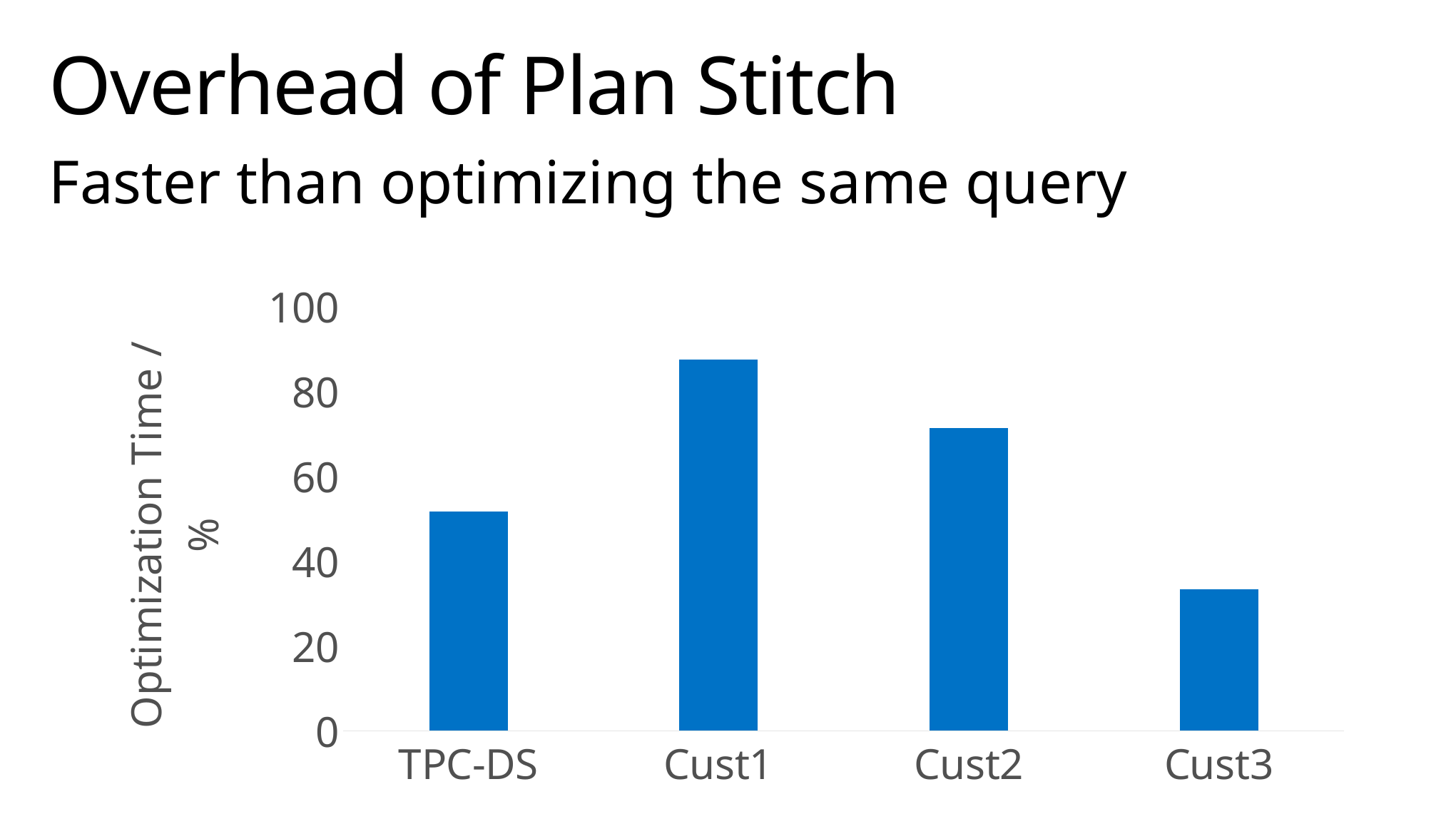
How many categories are plotted on the x axis? 4 What kind of chart is shown on the slide? bar chart Which category has the lowest optimization time? Cust3 Which is larger, the value for TPC-DS or the value for Cust3? TPC-DS Is the value for Cust1 greater or less than 80? greater Which category has the highest optimization time? Cust1 What is the highest tick value shown on the vertical axis? 100 Is the value for TPC-DS greater or less than 60? less What is the label on the vertical axis? Optimization Time / % Is the value for Cust3 greater or less than 40? less Which is larger, the value for Cust1 or the value for Cust2? Cust1